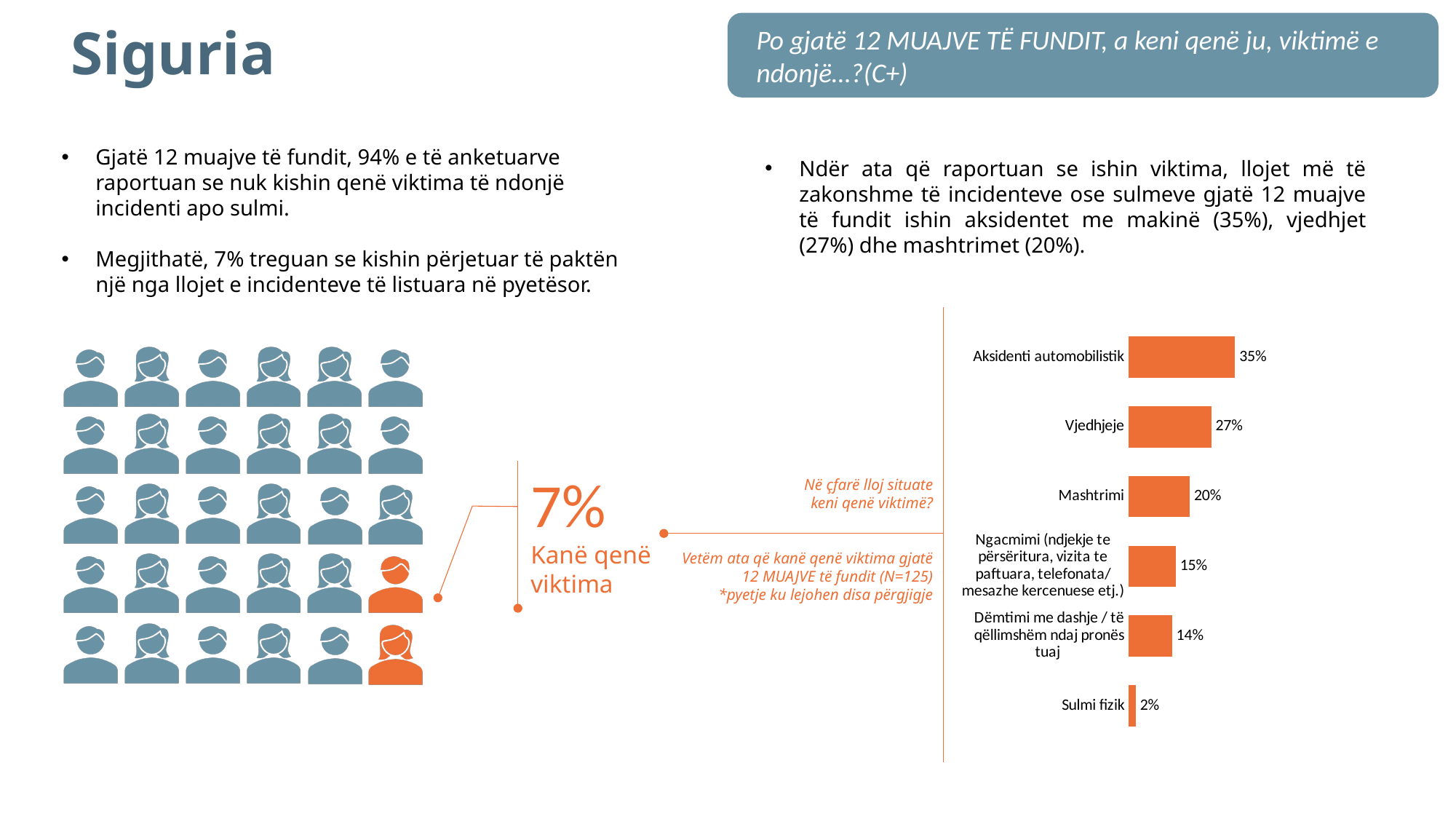
What is the value for Aksidenti automobilistik in the bar chart? 35% What is the value for Mashtrimi in the bar chart? 20% What is the difference between the values for Ngacmimi and Dëmtimi me dashje in the bar chart? 1% What is the difference between the values for Aksidenti automobilistik and Vjedhjeje in the bar chart? 8% What is the value for Vjedhjeje in the bar chart? 27% Which category has the highest value in the bar chart? Aksidenti automobilistik Which is larger in the bar chart: Mashtrimi or Sulmi fizik? Mashtrimi What colour are the bars in the bar chart? Orange How many categories are shown in the bar chart? 6 What kind of chart is shown on the right side of the slide? Bar chart Which category has the lowest value in the bar chart? Sulmi fizik What is the value for Sulmi fizik in the bar chart? 2%